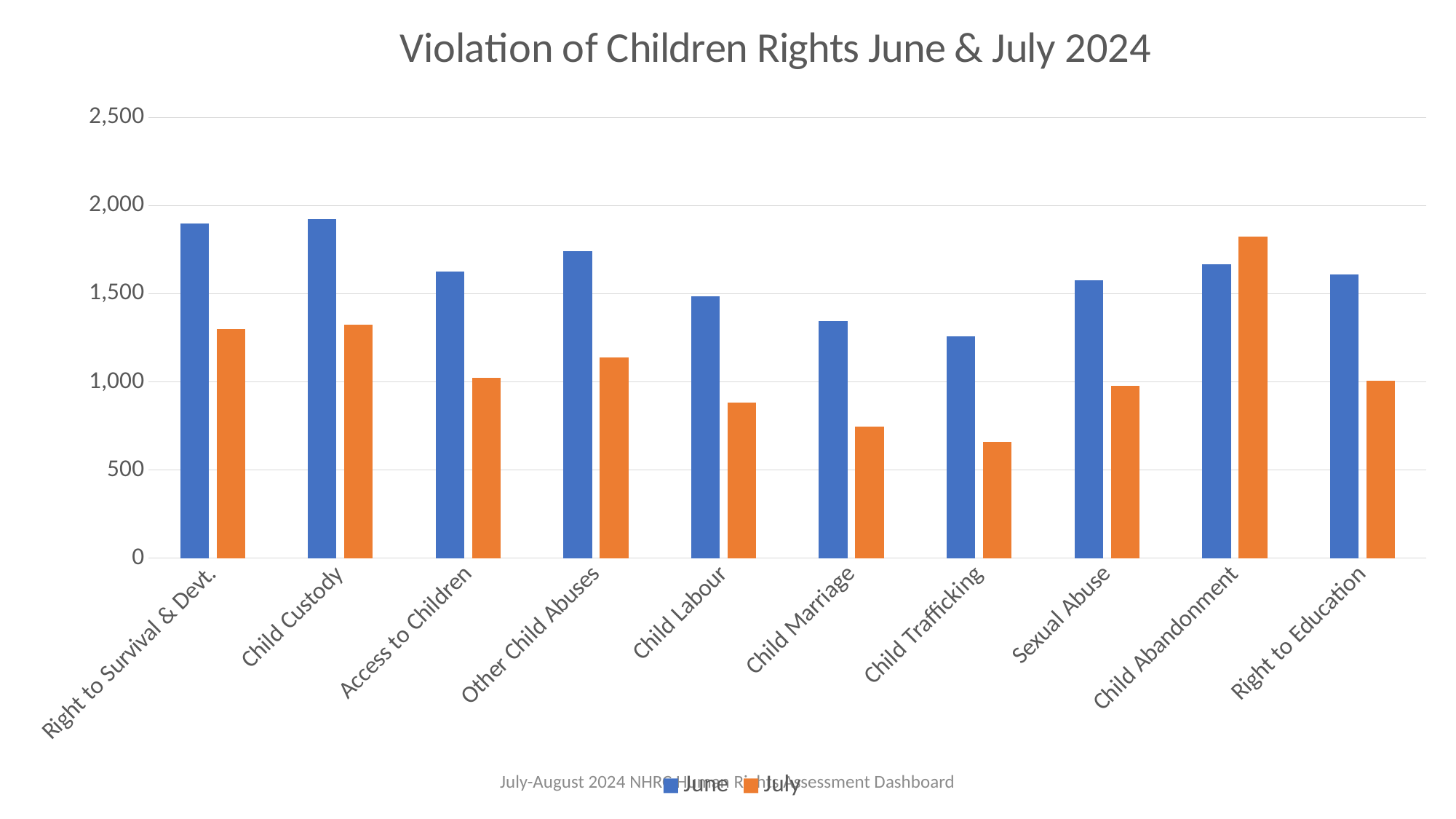
Which category has the lowest July value? Child Trafficking Which category has the highest July value? Child Abandonment Is the June value for Child Marriage greater or less than 1,500? less How many series does the legend list? 2 How many categories are shown on the x axis? 10 For Child Abandonment, which is larger, the June value or the July value? July Which category has the lowest June value? Child Trafficking Is the July value for Child Abandonment greater or less than 1,500? greater For Sexual Abuse, which is larger, the June value or the July value? June What is the title of the chart? Violation of Children Rights June & July 2024 Is the July value for Child Labour greater or less than 1,000? less What kind of chart is shown on the slide? bar chart